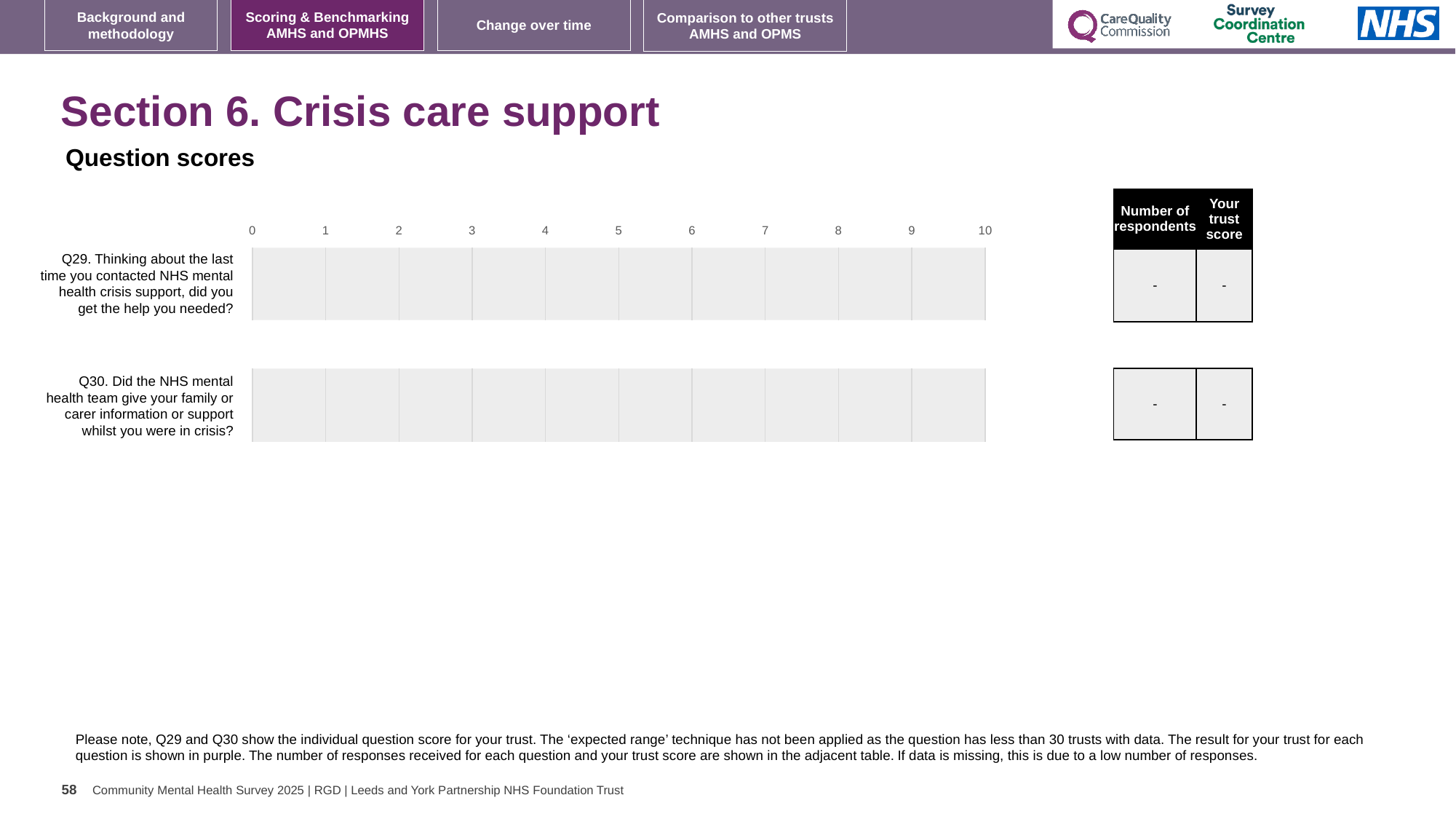
Which question label appears first (at the top) on the chart? Q29. Thinking about the last time you contacted NHS mental health crisis support, did you get the help you needed? What is the 'Your trust score' shown in the table for Q29? - What is the highest value shown on the chart's horizontal axis? 10 What is the 'Number of respondents' shown in the table for Q30? - How many questions (categories) are listed on the chart? 2 What is the lowest value shown on the chart's horizontal axis? 0 Are any bars plotted for Q29 or Q30 on the chart? No